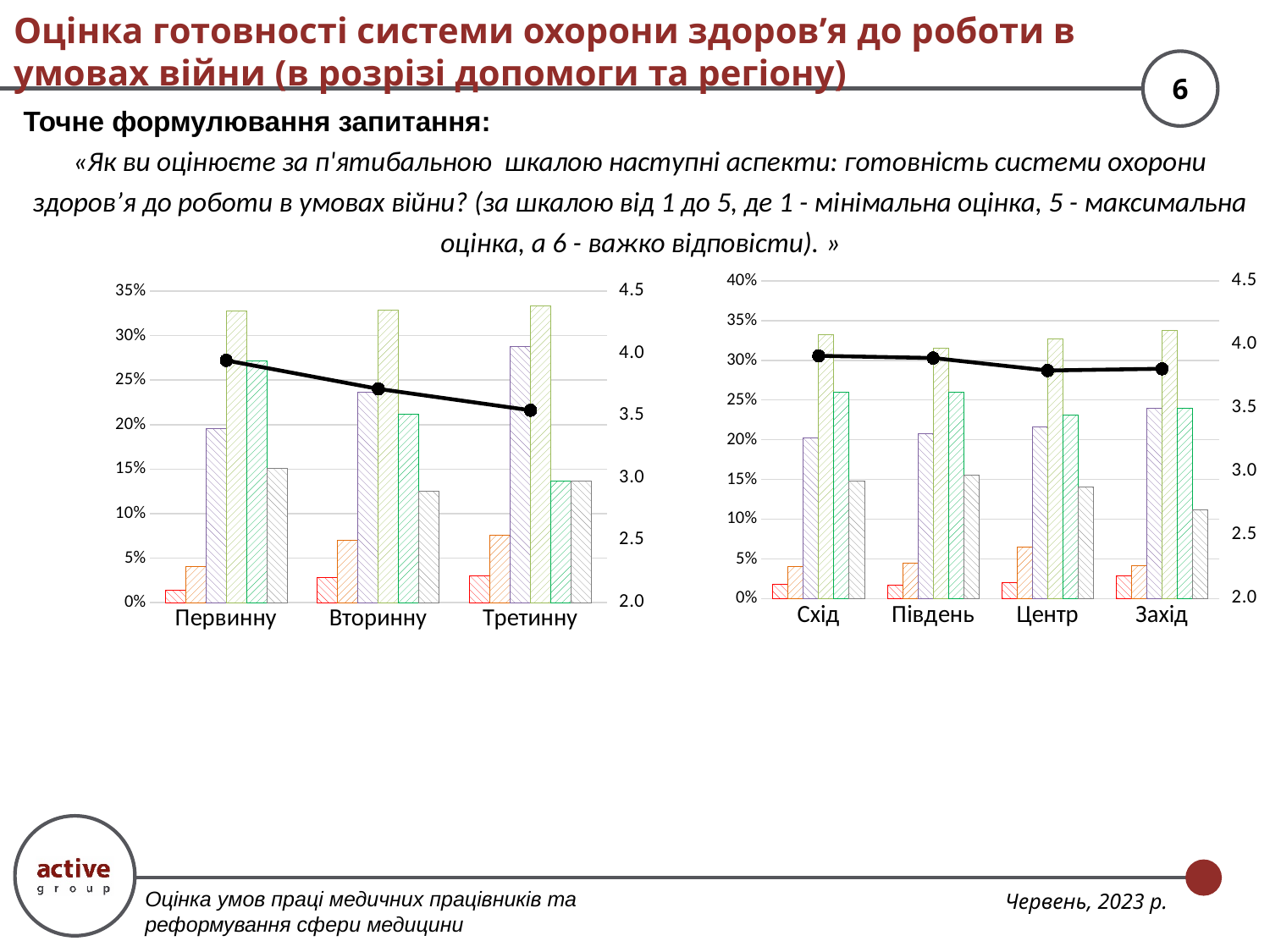
In the left chart, does the black line rise or fall from Первинну to Третинну? fall In the left chart, which category has the highest value on the black line? Первинну In the left chart, which category has the lowest value on the black line? Третинну In the right chart, which has the larger black line value, Схід or Центр? Схід In the right chart, is the black line value for Схід greater or less than 3.5 on the right axis? greater In the left chart, is the black line value for Третинну greater or less than 4.0 on the right axis? less In the right chart, is the tallest bar for Захід greater or less than 30%? greater What kind of chart is the left chart? bar chart with a line How many categories are shown on the x axis of the left chart? 3 How many categories are shown on the x axis of the right chart? 4 What is the highest tick shown on the left percentage axis of the right chart? 40%